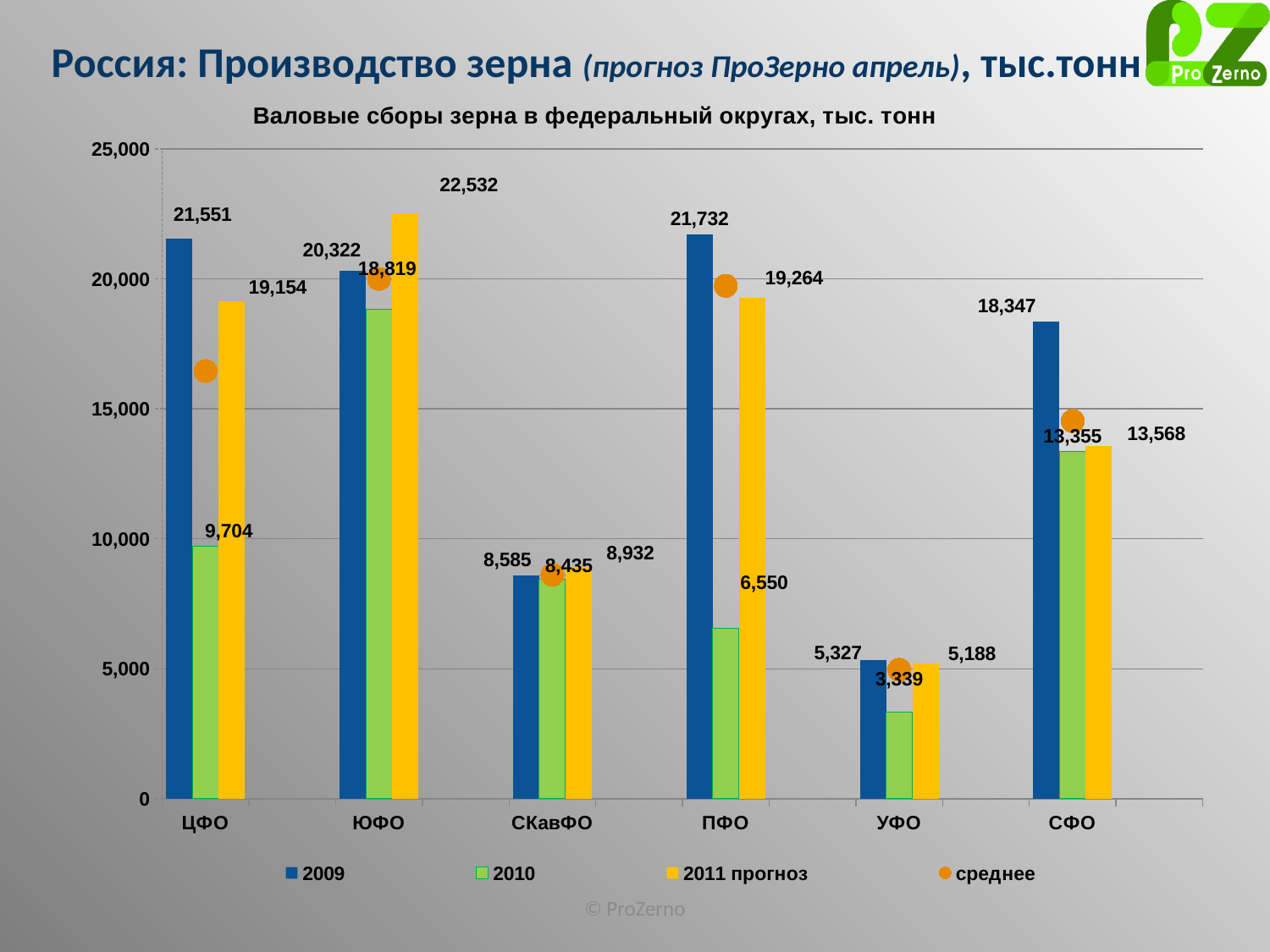
What is the difference between the 2009 and 2010 values for ЦФО? 11,847 Is the среднее value for ЦФО greater or less than 15,000? greater Which is larger for СКавФО: the 2009 value or the 2011 прогноз value? 2011 прогноз Which federal district has the highest 2011 прогноз value? ЮФО Which federal district has the lowest 2010 value? УФО What is the 2011 прогноз value for СФО? 13,568 What is the value for 2009 in ЦФО? 21,551 How many federal districts are shown on the x axis? 6 What is the 2011 прогноз value for ЮФО? 22,532 What is the value for 2010 in ПФО? 6,550 How many series does the legend list? 4 What kind of chart is shown on the slide? bar chart